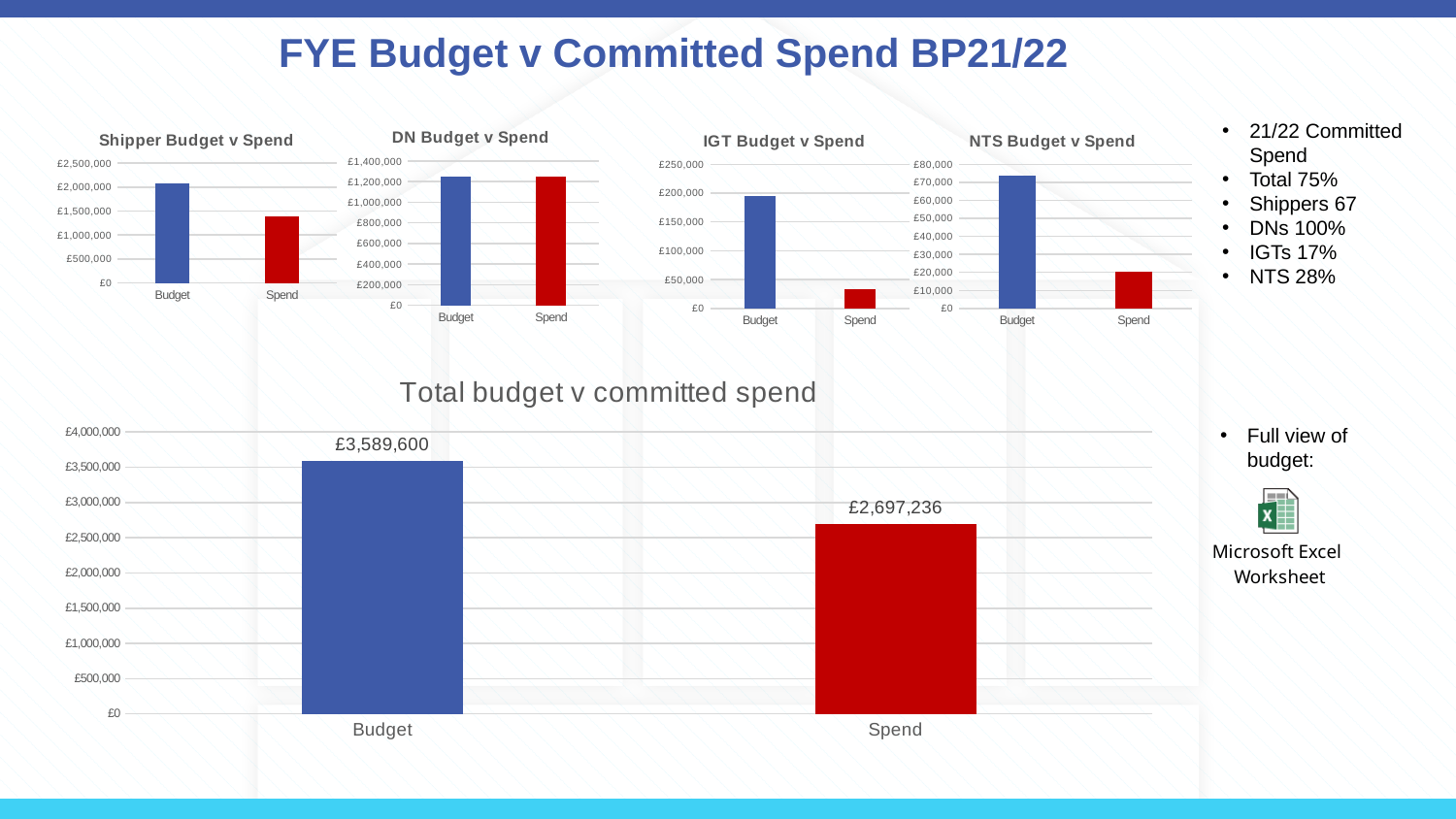
In the 'IGT Budget v Spend' chart, is the value for Spend greater or less than £50,000? less In the 'DN Budget v Spend' chart, is the value for Budget greater or less than £1,000,000? greater How many categories are shown on the x axis of the 'Total budget v committed spend' chart? 2 In the 'Total budget v committed spend' chart, what is the difference between the Budget and Spend values? £892,364 In the 'Shipper Budget v Spend' chart, is the value for Spend greater or less than £1,000,000? greater In the 'IGT Budget v Spend' chart, which category has the lowest value? Spend What type of chart is the 'Total budget v committed spend' chart? Bar chart In the 'Shipper Budget v Spend' chart, which bar is taller, Budget or Spend? Budget In the 'Total budget v committed spend' chart, what is the value for Budget? £3,589,600 In the 'Total budget v committed spend' chart, which category is higher, Budget or Spend? Budget In the 'Total budget v committed spend' chart, what is the value for Spend? £2,697,236